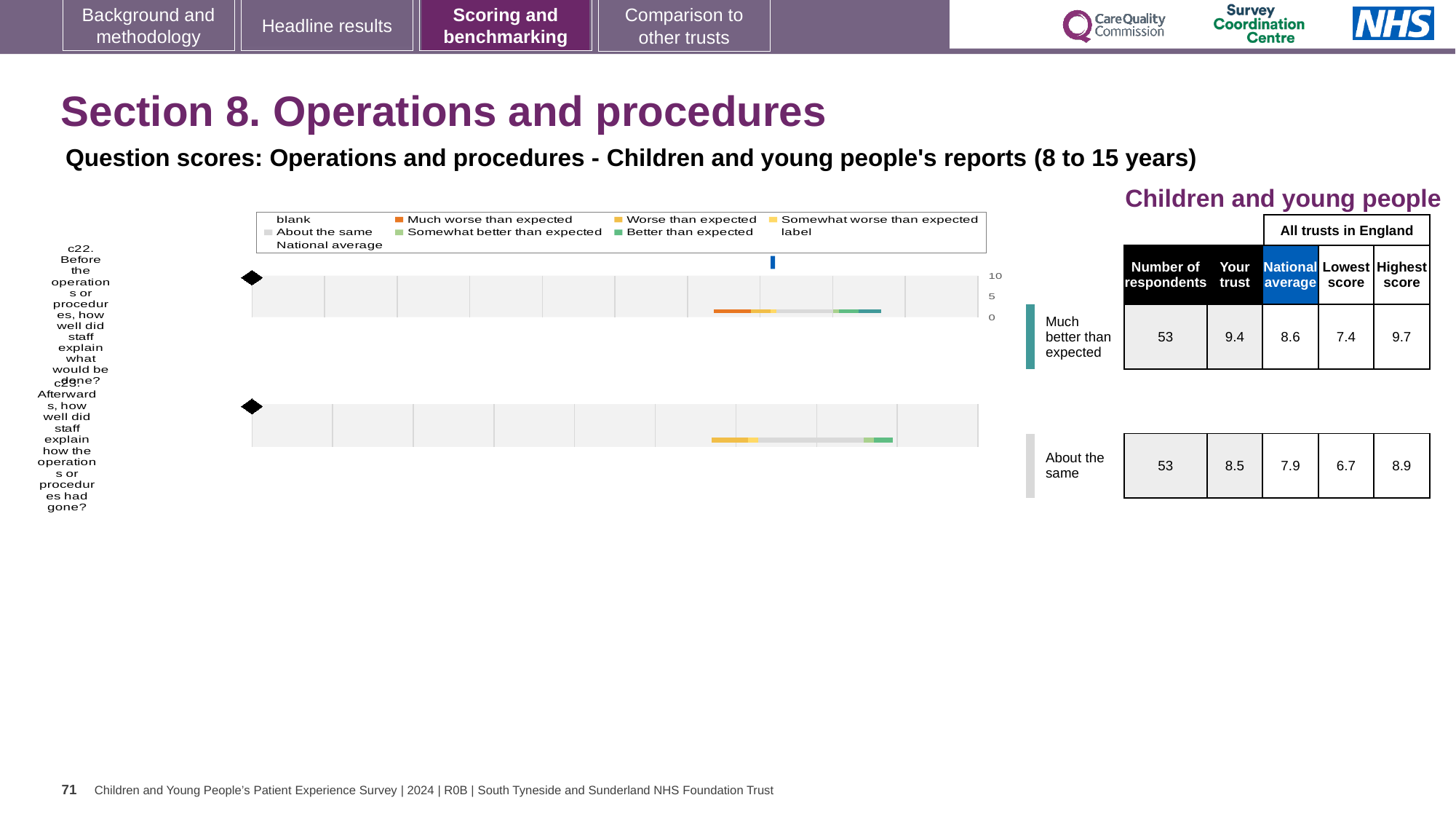
For c23, what is the 'Your trust' score shown in the table? 8.5 For c22, what is the National average score shown in the table? 8.6 What is the highest tick value shown on the score axis of the charts? 10 How many survey questions (charts) are plotted on the slide? 2 For c23, what is the Lowest score among all trusts in England? 6.7 Which legend entry is shown in orange? Much worse than expected Which benchmark category is c22 placed in? Much better than expected What kind of chart is used to show the question scores for c22 and c23? bar chart For c22 (Before the operations or procedures, how well did staff explain what would be done?), what is the 'Your trust' score shown in the table? 9.4 For c22, is the 'Your trust' score higher or lower than the National average? higher For c22, what is the difference between the 'Your trust' score and the National average? 0.8 How many respondents are listed for c23 (Afterwards, how well did staff explain how the operations or procedures had gone?)? 53